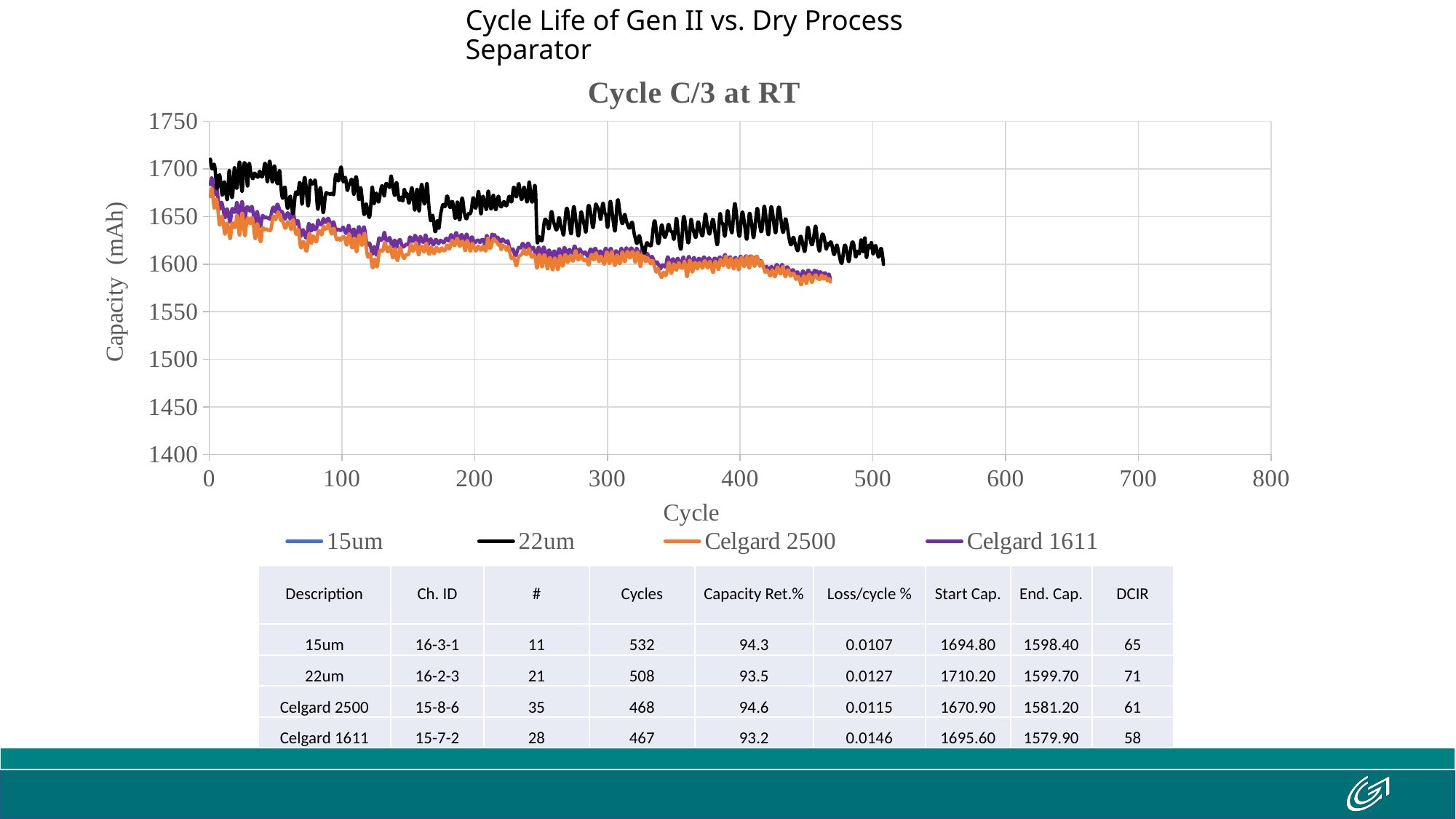
Does the capacity of the Celgard 2500 series rise or fall along the x axis? fall Is the capacity of the 22um series at cycle 100 greater or less than 1650? greater Is the capacity of the Celgard 2500 series at cycle 400 greater or less than 1650? less At cycle 200, which series has the higher capacity, 22um or Celgard 2500? 22um Which plotted series extends to the highest cycle number on the chart? 22um Does the capacity of the 22um series rise or fall as the cycle number increases? fall Is the capacity of the Celgard 1611 series at cycle 0 greater or less than 1650? greater What is the title of the chart? Cycle C/3 at RT At cycle 300, which series has the higher capacity, 22um or Celgard 1611? 22um What kind of chart is shown on the slide? line chart How many series does the chart legend list? 4 What is the label of the vertical axis of the chart? Capacity (mAh)